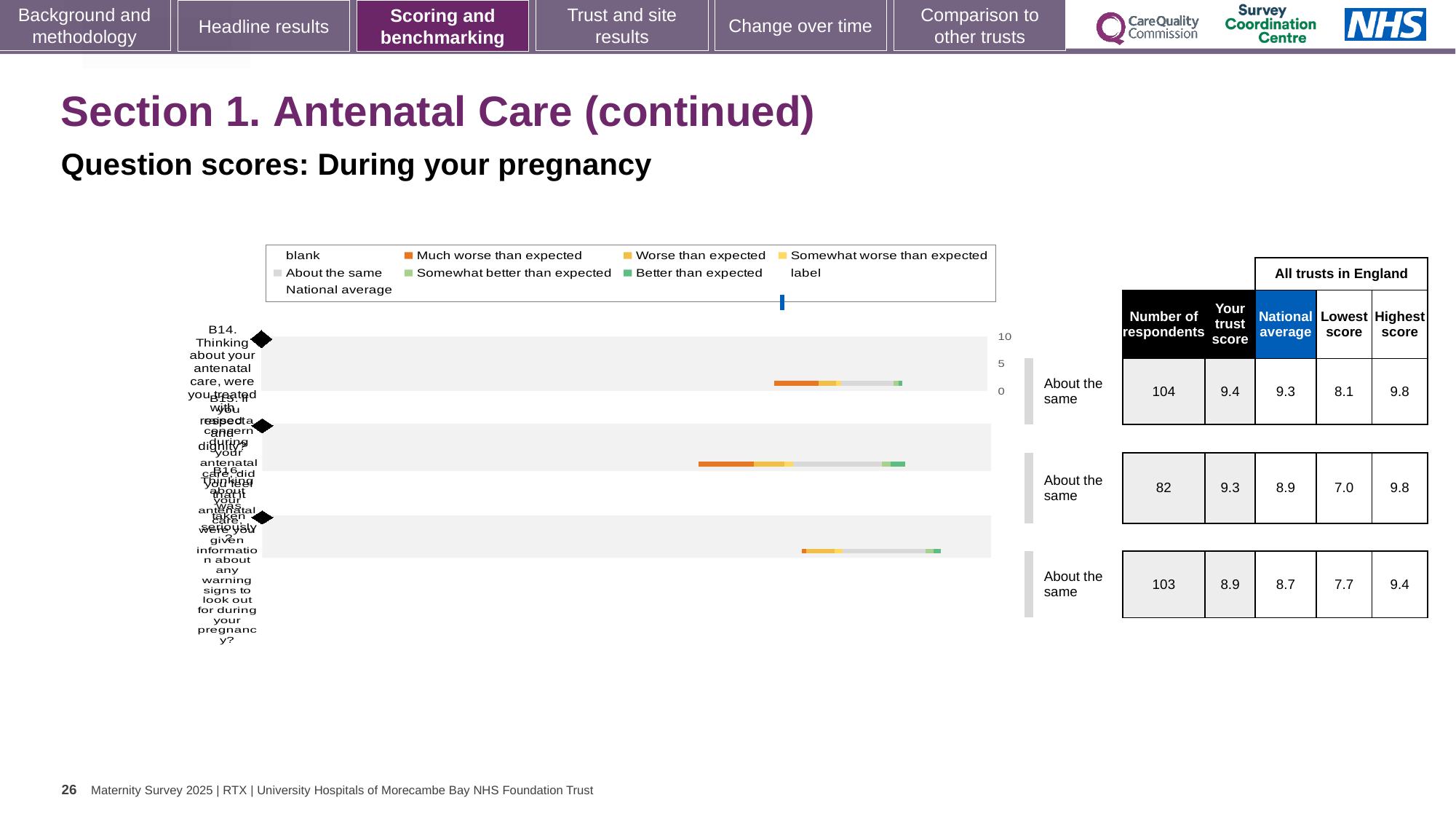
In the table beside the chart, is the trust score for the first row larger or smaller than its national average? larger What kind of chart is shown on the slide? bar chart What colour does the legend use for 'Much worse than expected'? orange In the table beside the chart, what is the difference between the trust score and the national average for the second row? 0.4 What colour does the legend use for 'Better than expected'? green How many bars (question rows) does the chart show? 3 What benchmark category is shown next to each of the three bars? About the same In the table beside the chart, which row has the lowest 'Lowest score' value? the second row (7.0) In the table beside the chart, what is the 'Your trust score' for the first row (B14)? 9.4 In the table beside the chart, what is the national average for the third row? 8.7 In the table beside the chart, what is the number of respondents for the second row? 82